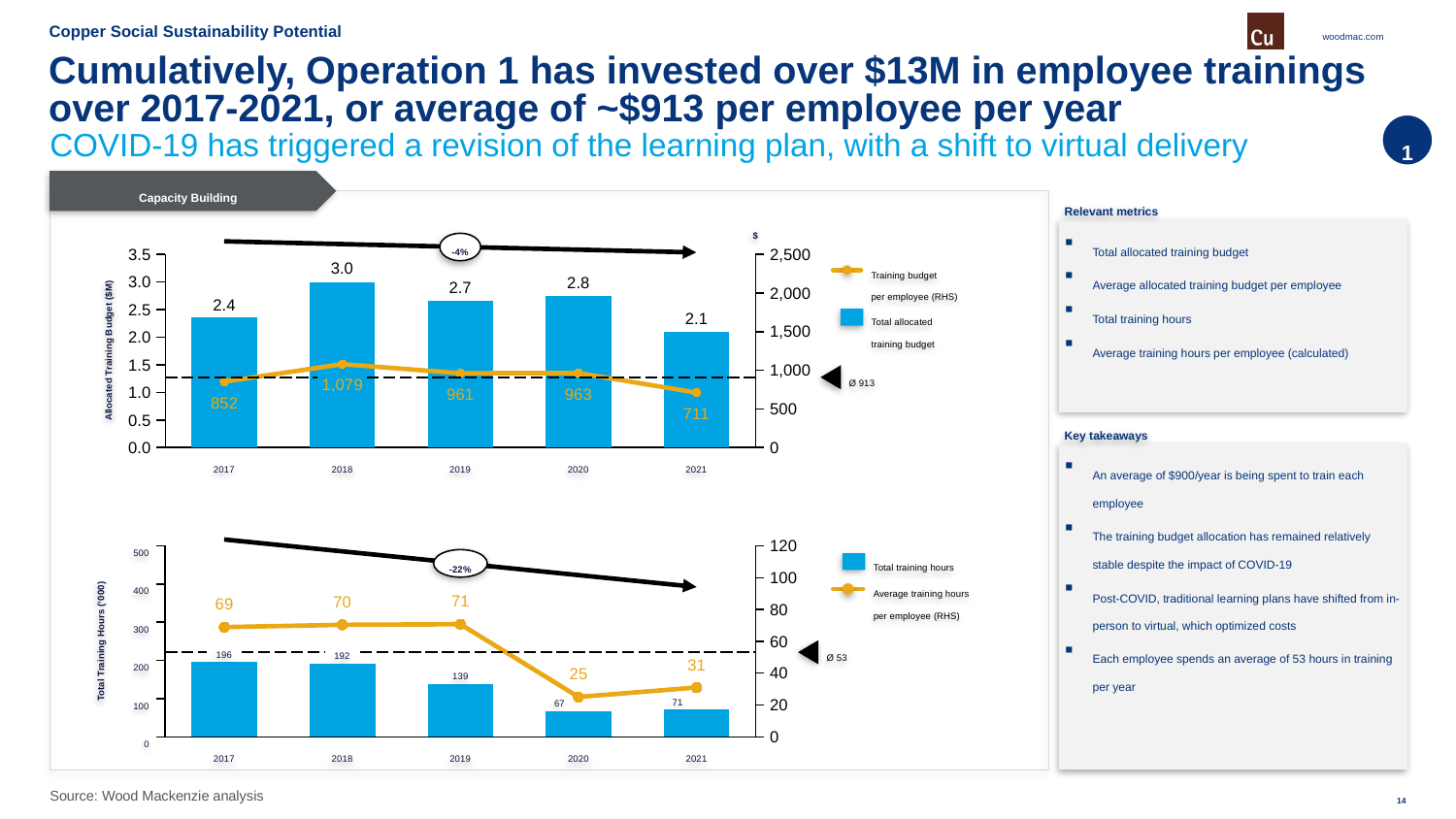
In the bottom chart, how many years are shown on the x axis? 5 In the top chart, what is the training budget per employee for 2021? 711 In the top chart, what is the total allocated training budget for 2018? 3.0 In the top chart, what is the difference between the training budget per employee in 2018 and in 2017? 227 In the bottom chart, what is the difference in total training hours between 2017 and 2021? 125 In the top chart, which year has the lowest training budget per employee? 2021 In the bottom chart, is the total training hours value for 2020 larger or smaller than the value for 2021? smaller In the bottom chart, which year has the highest total training hours? 2017 In the top chart, how many series does the legend list? 2 In the bottom chart, what is the total training hours value for 2019? 139 In the bottom chart, what is the average training hours per employee for 2020? 25 In the top chart, which year has the highest total allocated training budget? 2018